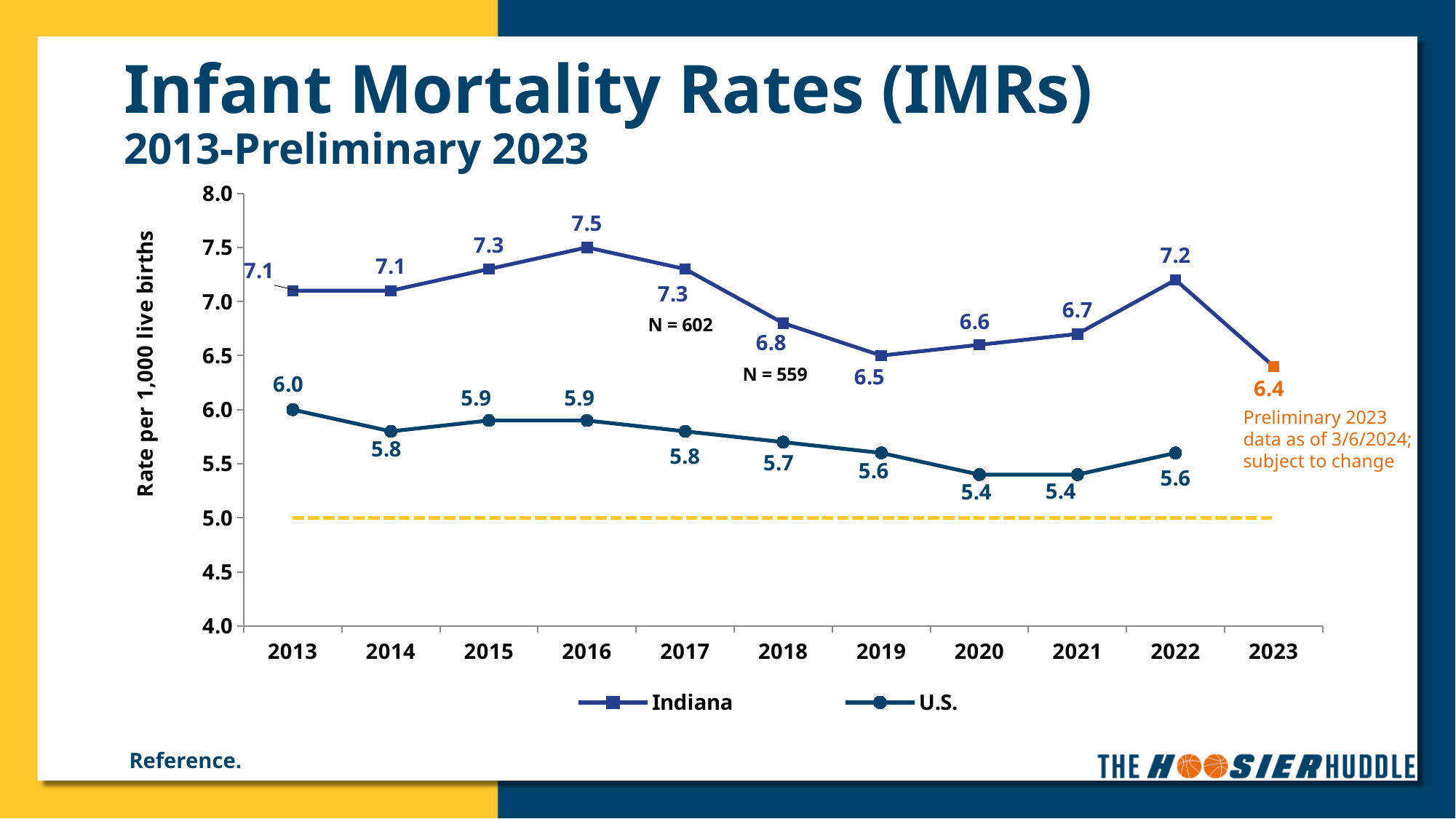
What is the label on the y axis? Rate per 1,000 live births What kind of chart is shown on the slide? Line chart How many years are shown on the x axis? 11 Did Indiana's infant mortality rate rise or fall from 2022 to 2023? Fall What is Indiana's preliminary 2023 infant mortality rate? 6.4 What was Indiana's infant mortality rate in 2016? 7.5 What is the difference between Indiana's and the U.S. infant mortality rate in 2022? 1.6 What was the U.S. infant mortality rate in 2020? 5.4 In which year was Indiana's infant mortality rate lowest? 2023 Which had the higher infant mortality rate in 2019, Indiana or the U.S.? Indiana In which year was Indiana's infant mortality rate highest? 2016 How many series does the legend list? 2